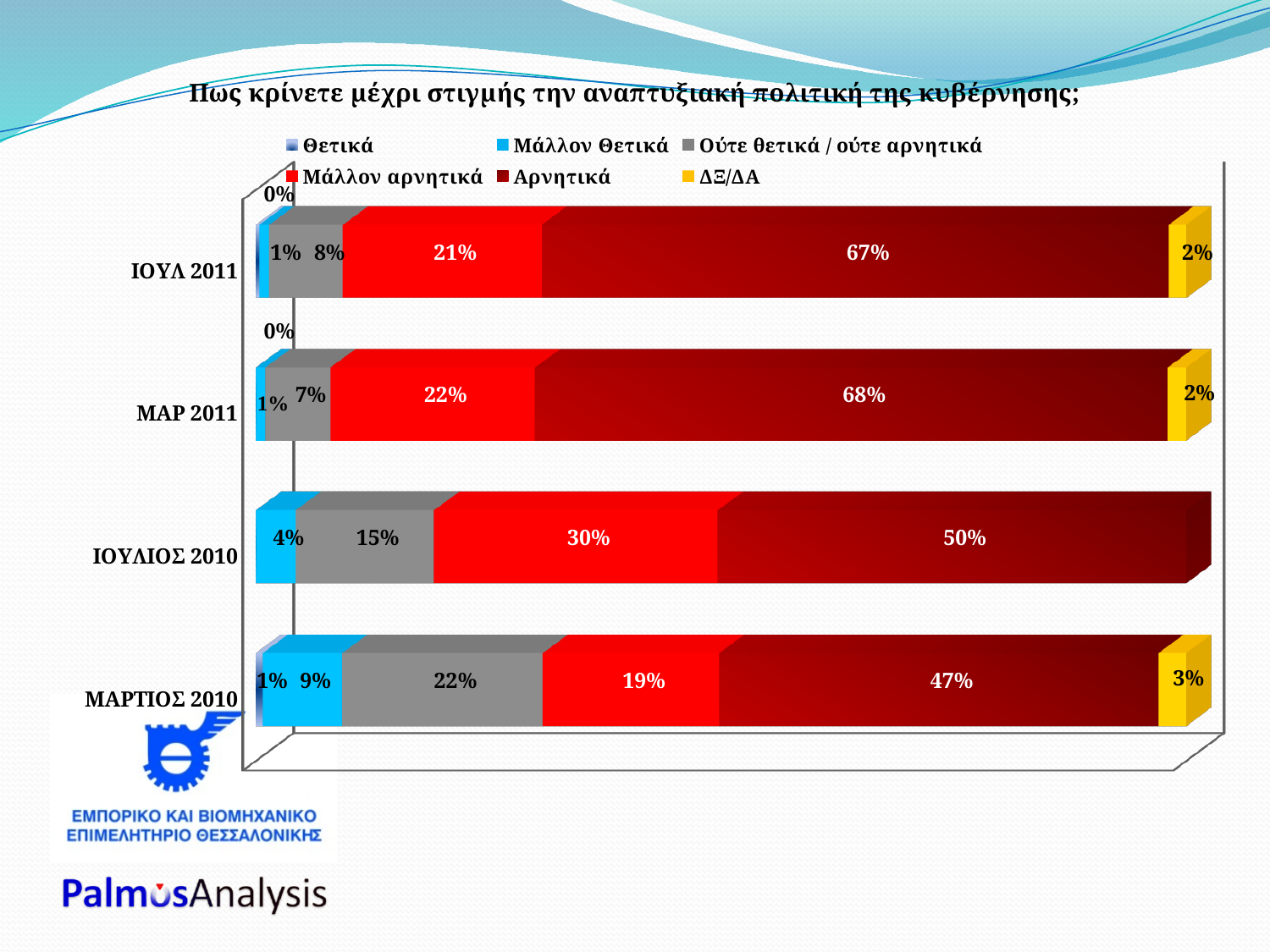
Which is larger: Μάλλον αρνητικά for ΙΟΥΛΙΟΣ 2010 or Μάλλον αρνητικά for ΙΟΥΛ 2011? ΙΟΥΛΙΟΣ 2010 What is the value of Αρνητικά for ΙΟΥΛ 2011? 67% Which survey period has the highest value for Αρνητικά? ΜΑΡ 2011 Which survey period has the lowest value for Αρνητικά? ΜΑΡΤΙΟΣ 2010 What is the value of ΔΞ/ΔΑ for ΜΑΡΤΙΟΣ 2010? 3% What is the difference between the Αρνητικά values for ΜΑΡ 2011 and ΜΑΡΤΙΟΣ 2010? 21% What is the value of Μάλλον αρνητικά for ΜΑΡ 2011? 22% How many series does the legend list? 6 What type of chart is shown on the slide? stacked bar chart What is the title of the chart? Πως κρίνετε μέχρι στιγμής την αναπτυξιακή πολιτική της κυβέρνησης; How many categories (survey periods) are shown on the chart? 4 What is the value of Ούτε θετικά / ούτε αρνητικά for ΙΟΥΛΙΟΣ 2010? 15%